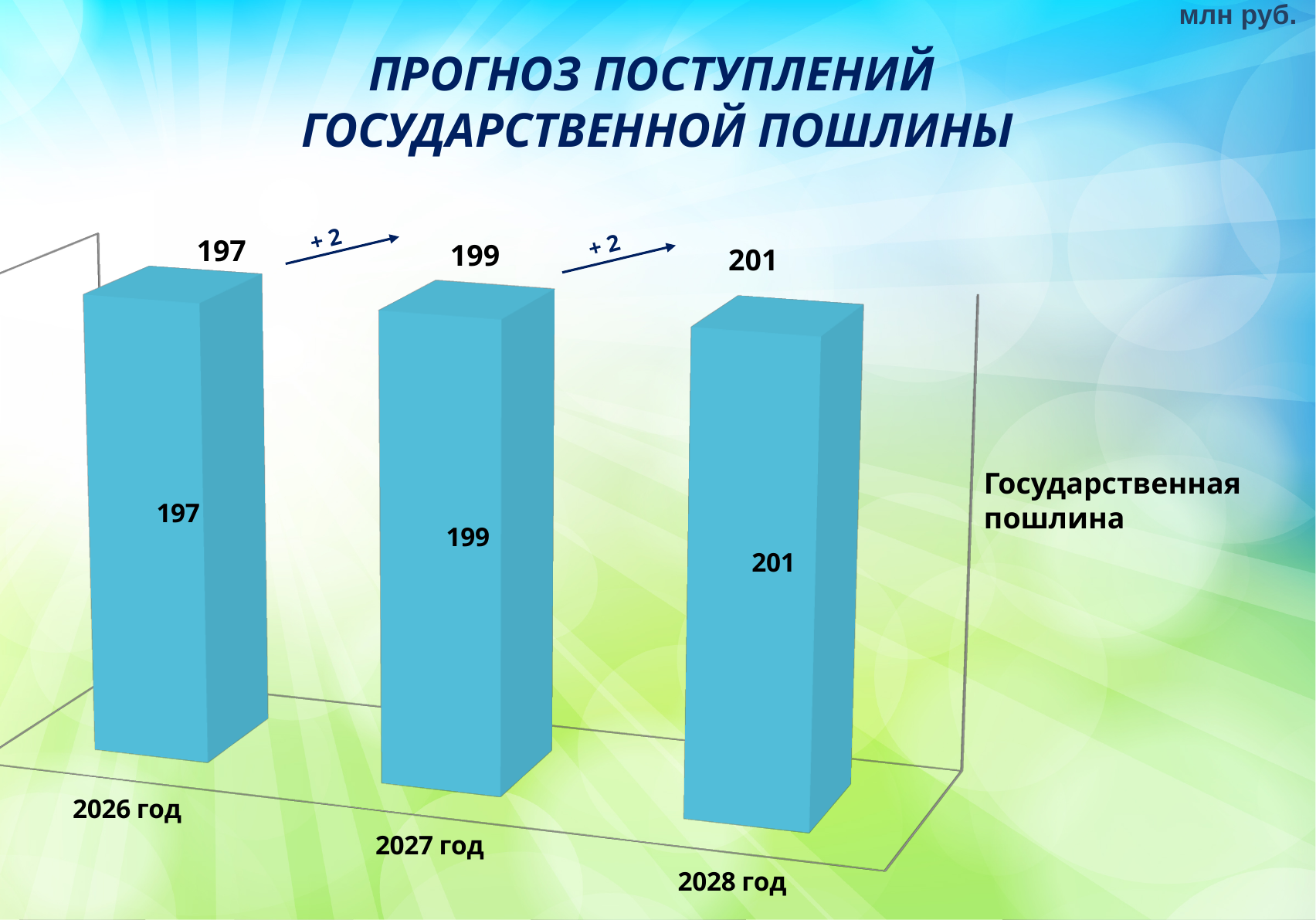
What is the forecast value of state duty receipts for 2026 год? 197 What is the forecast value of state duty receipts for 2028 год? 201 In what units are the values on the chart given? млн руб. Which year has the lowest forecast value of state duty receipts? 2026 год What is the forecast value of state duty receipts for 2027 год? 199 What is the difference between the values for 2028 год and 2026 год? 4 What is the difference between the values for 2027 год and 2026 год? 2 Which year has the highest forecast value of state duty receipts? 2028 год What kind of chart is shown on the slide? bar chart Which is larger, the value for 2027 год or the value for 2028 год? 2028 год How many years (categories) are shown in the chart? 3 Do the values rise or fall from 2026 год to 2028 год? rise